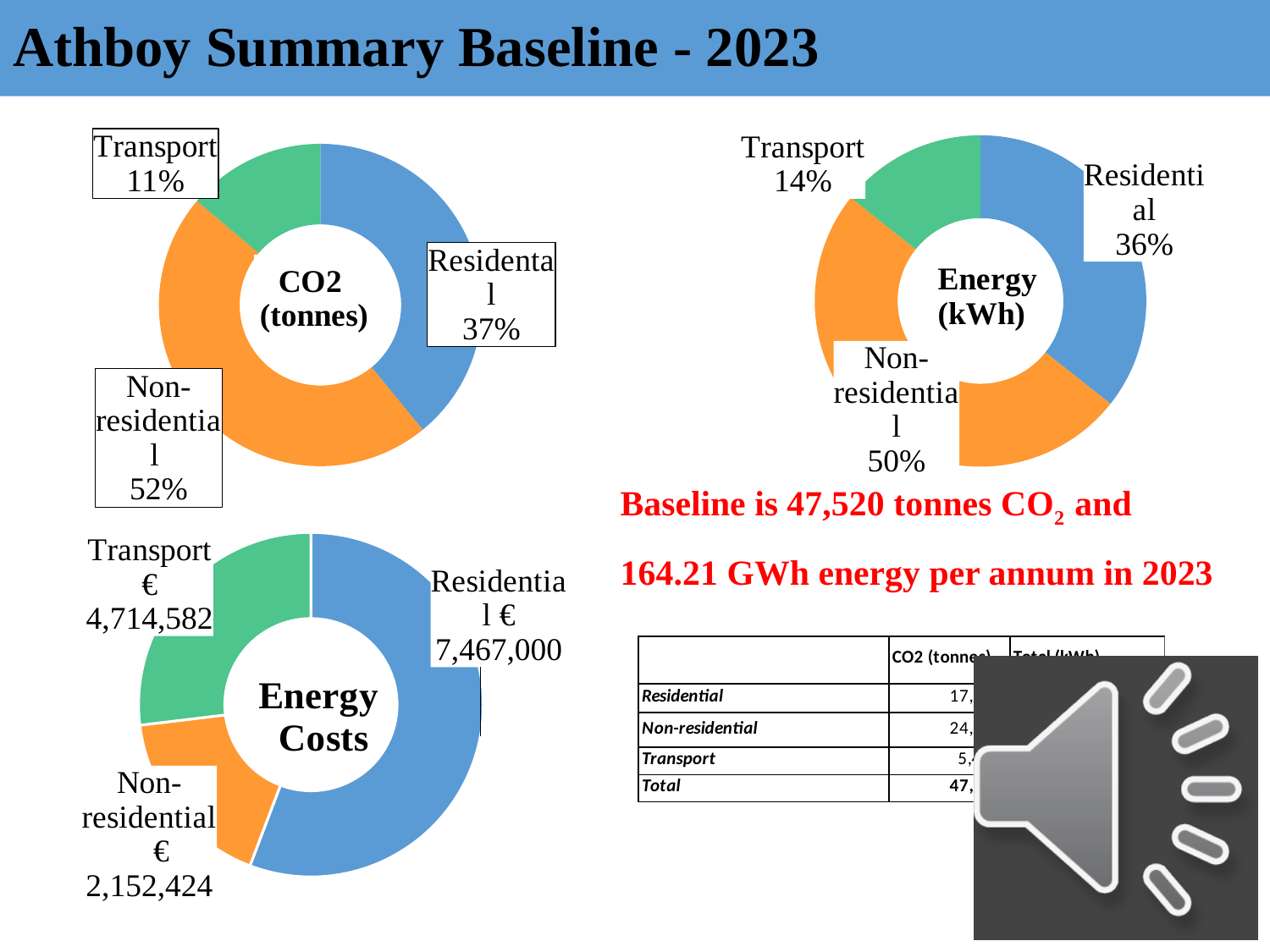
In the CO2 (tonnes) chart, which category has the largest share? Non-residential In the Energy (kWh) chart, what is the difference between the Non-residential and Transport shares? 36% In the CO2 (tonnes) chart, what share does Transport have? 11% In the CO2 (tonnes) chart, which category has the smallest share? Transport In the Energy (kWh) chart, what share does Residential have? 36% In the Energy Costs chart, what is the value for Non-residential? €2,152,424 How many categories does the Energy Costs chart show? 3 In the CO2 (tonnes) chart, what share does Non-residential have? 52% In the Energy Costs chart, what is the value for Residential? €7,467,000 What type of chart is the CO2 (tonnes) chart? Doughnut chart In the Energy (kWh) chart, which is larger, Residential or Transport? Residential In the Energy Costs chart, which category has the lowest value? Non-residential